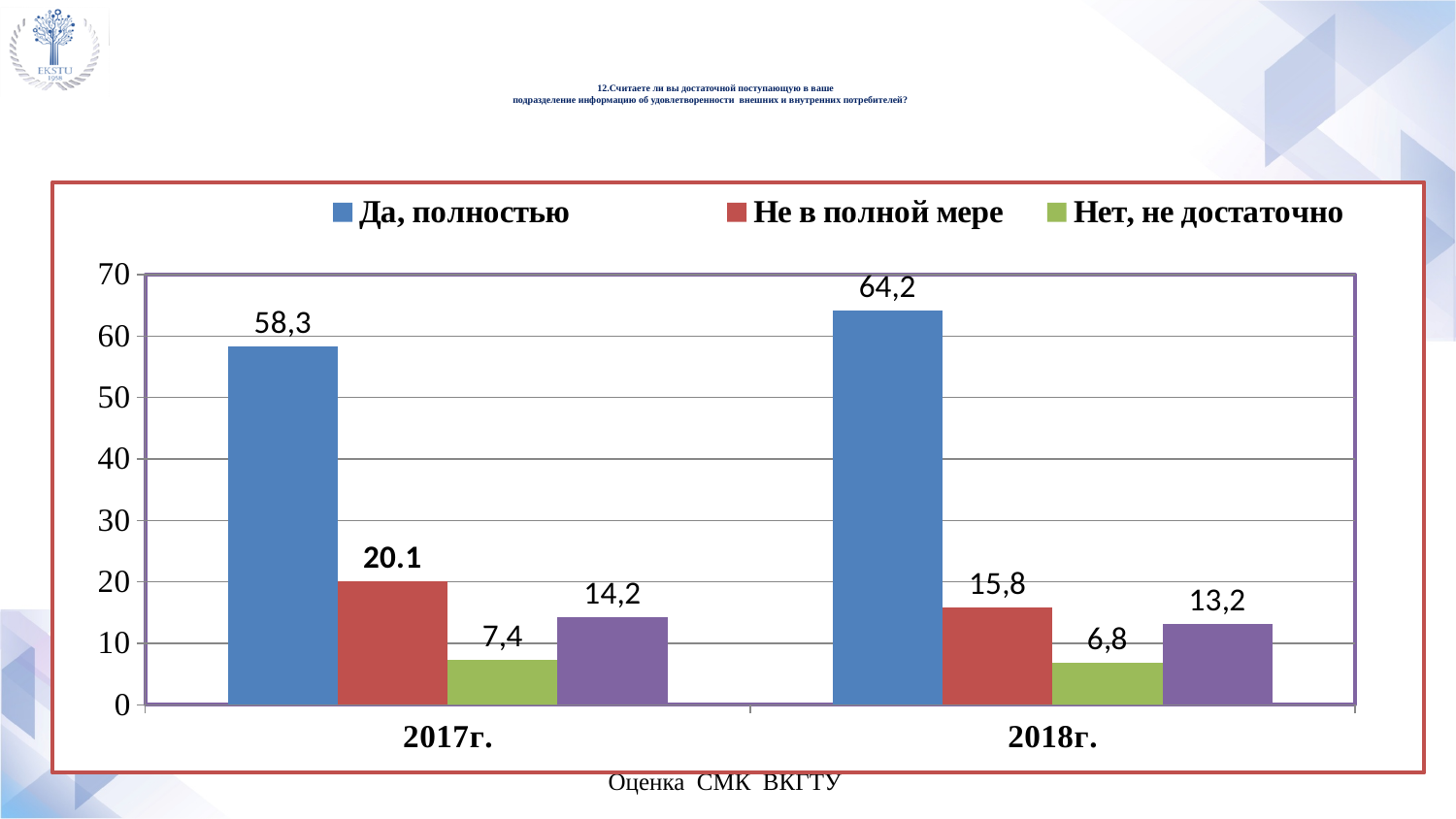
What is the value for "Да, полностью" in 2018г.? 64,2 How many series does the legend list? 3 What is the value for "Нет, не достаточно" in 2018г.? 6,8 Does the value for "Да, полностью" rise or fall from 2017г. to 2018г.? Rise What is the value for "Да, полностью" in 2017г.? 58,3 What is the difference between the "Да, полностью" values for 2018г. and 2017г.? 5,9 Which series has the highest value in 2018г.? Да, полностью Which is larger: "Не в полной мере" in 2017г. or in 2018г.? 2017г. Which series has the lowest value in 2017г.? Нет, не достаточно What is the value for "Не в полной мере" in 2018г.? 15,8 What kind of chart is shown on the slide? Bar chart What is the value for "Нет, не достаточно" in 2017г.? 7,4